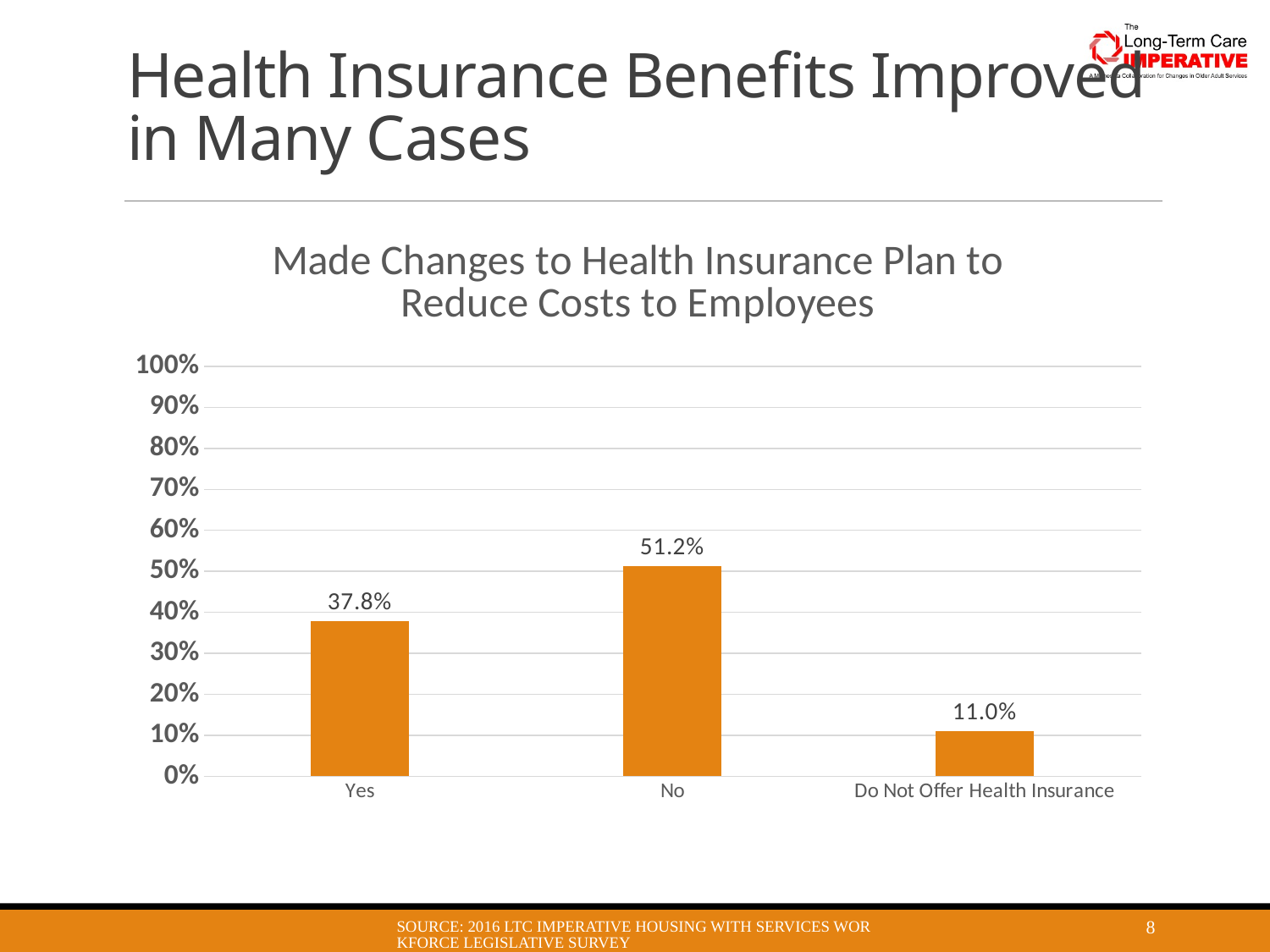
What percentage of respondents answered "Yes" to making changes to their health insurance plan to reduce costs to employees? 37.8% What is the value shown for the "No" category? 51.2% Which category has the lowest value? Do Not Offer Health Insurance Which is larger, the value for "Yes" or the value for "No"? No What is the difference between the "No" and "Yes" values? 13.4% What type of chart is shown on the slide? Bar chart Is the value for "No" greater or less than 50%? greater What is the difference between the "Yes" value and the "Do Not Offer Health Insurance" value? 26.8% Which category has the highest value? No What percentage is shown for "Do Not Offer Health Insurance"? 11.0% What is the title of the chart? Made Changes to Health Insurance Plan to Reduce Costs to Employees How many categories are shown on the chart? 3